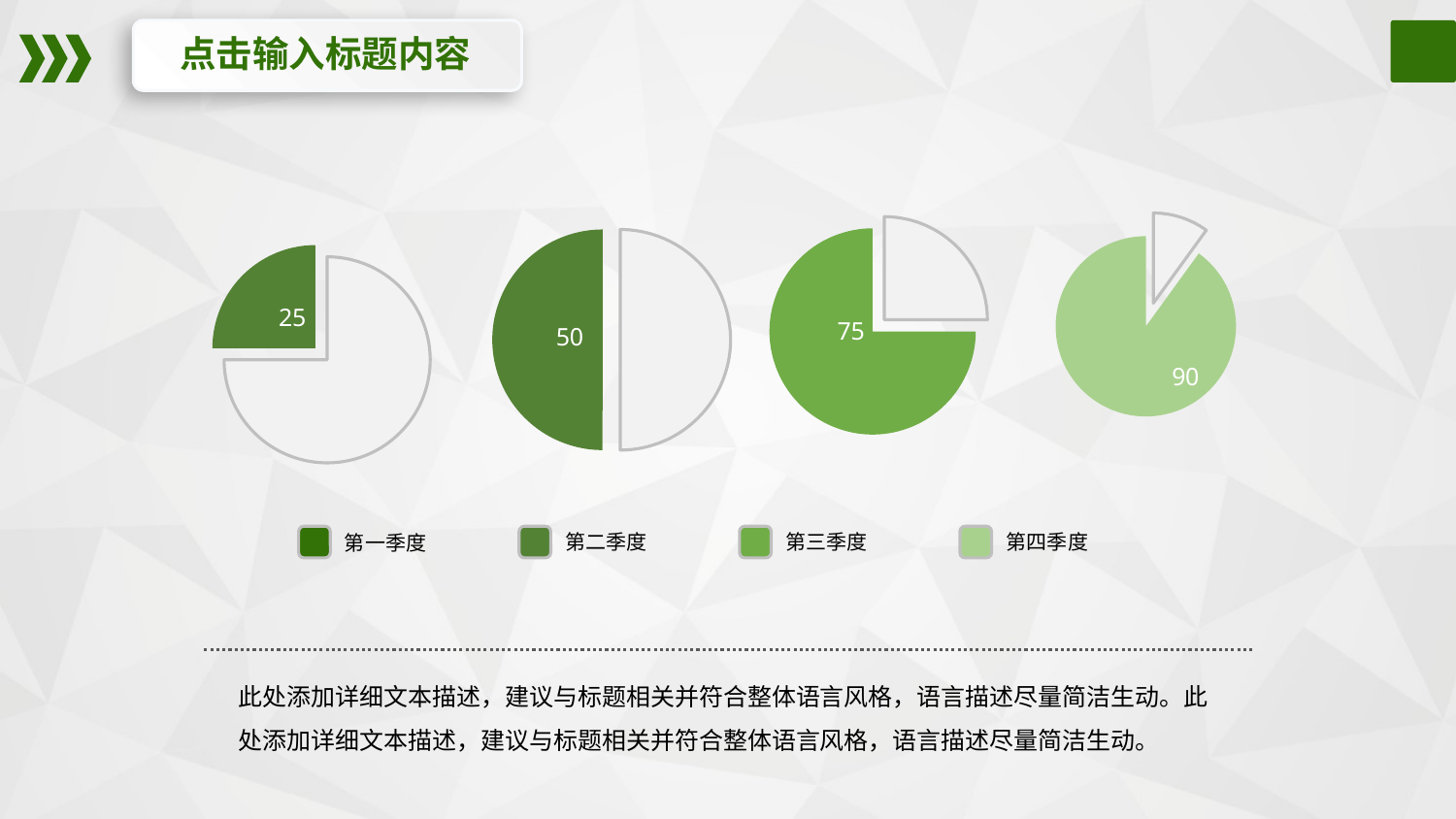
What value is shown for 第二季度 (the second pie chart)? 50 How many entries does the legend list? 4 What is the difference between the values for 第四季度 and 第一季度? 65 What value is shown for 第一季度 (the first pie chart)? 25 What is the difference between the values for 第三季度 and 第二季度? 25 Which quarter has the lowest value among the four pie charts? 第一季度 Which is larger, the value for 第二季度 or the value for 第三季度? 第三季度 What value is shown for 第三季度 (the third pie chart)? 75 Which quarter has the highest value among the four pie charts? 第四季度 What kind of chart is used on this slide? Pie chart What value is shown for 第四季度 (the fourth pie chart)? 90 Do the values rise or fall from 第一季度 to 第四季度 across the four pie charts? Rise